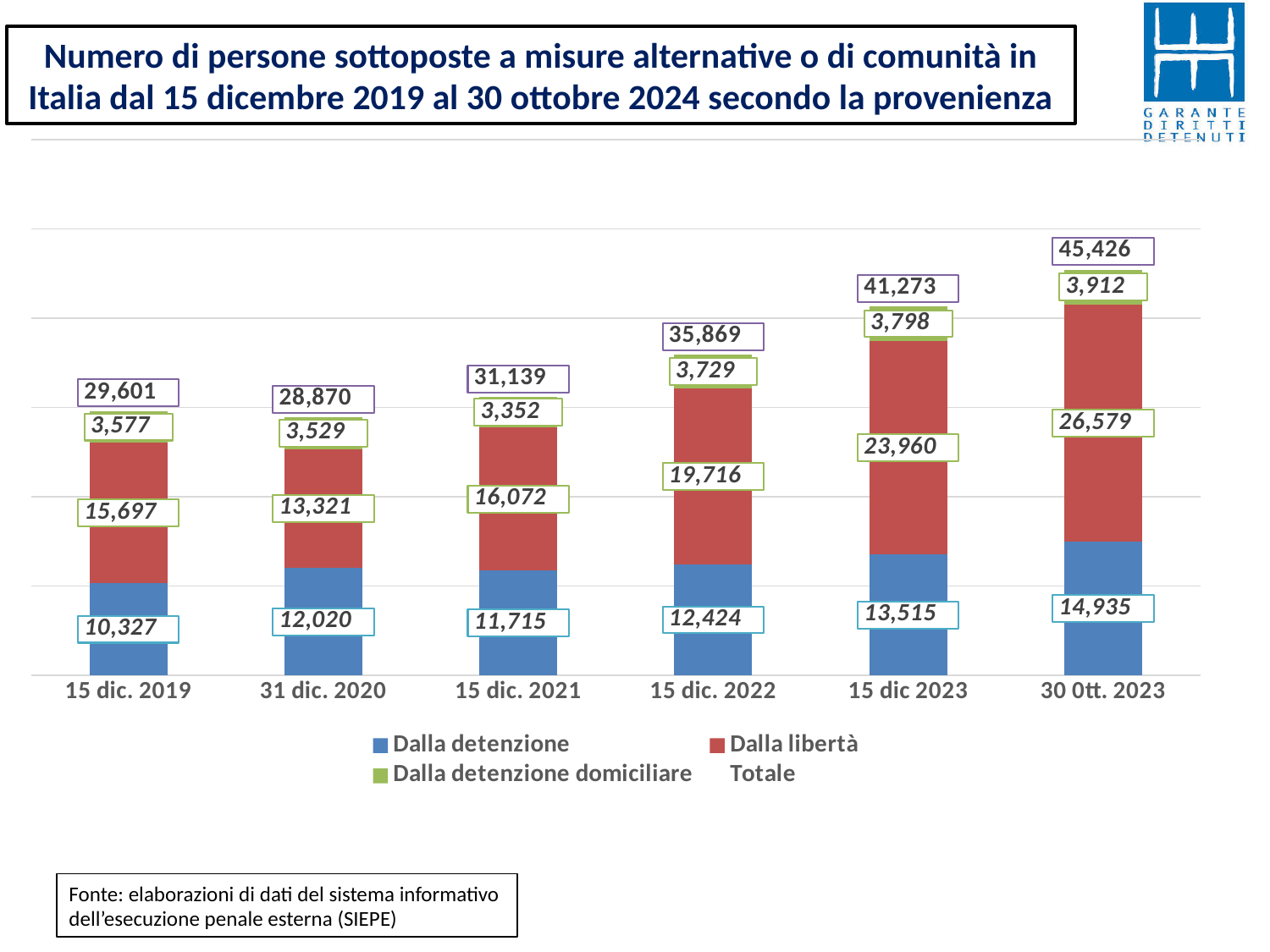
What is the value for 'Dalla libertà' at 15 dic. 2022? 19,716 Which date has the lowest value for 'Dalla detenzione domiciliare'? 15 dic. 2021 How many series does the legend list? 4 What kind of chart is shown on the slide? Stacked bar chart What is the value for 'Dalla detenzione' at 15 dic. 2019? 10,327 Does the 'Dalla libertà' value rise or fall from 15 dic. 2021 to 30 Ott. 2023? Rise What is the difference between the 'Dalla libertà' value at 30 Ott. 2023 and at 15 dic. 2019? 10,882 How many dates are shown on the x axis? 6 What is the 'Totale' value shown for 15 dic 2023? 41,273 Which is larger, the 'Dalla detenzione' value at 31 dic. 2020 or at 15 dic. 2021? 31 dic. 2020 Which date has the lowest 'Totale' value? 31 dic. 2020 Which date has the highest 'Totale' value? 30 Ott. 2023